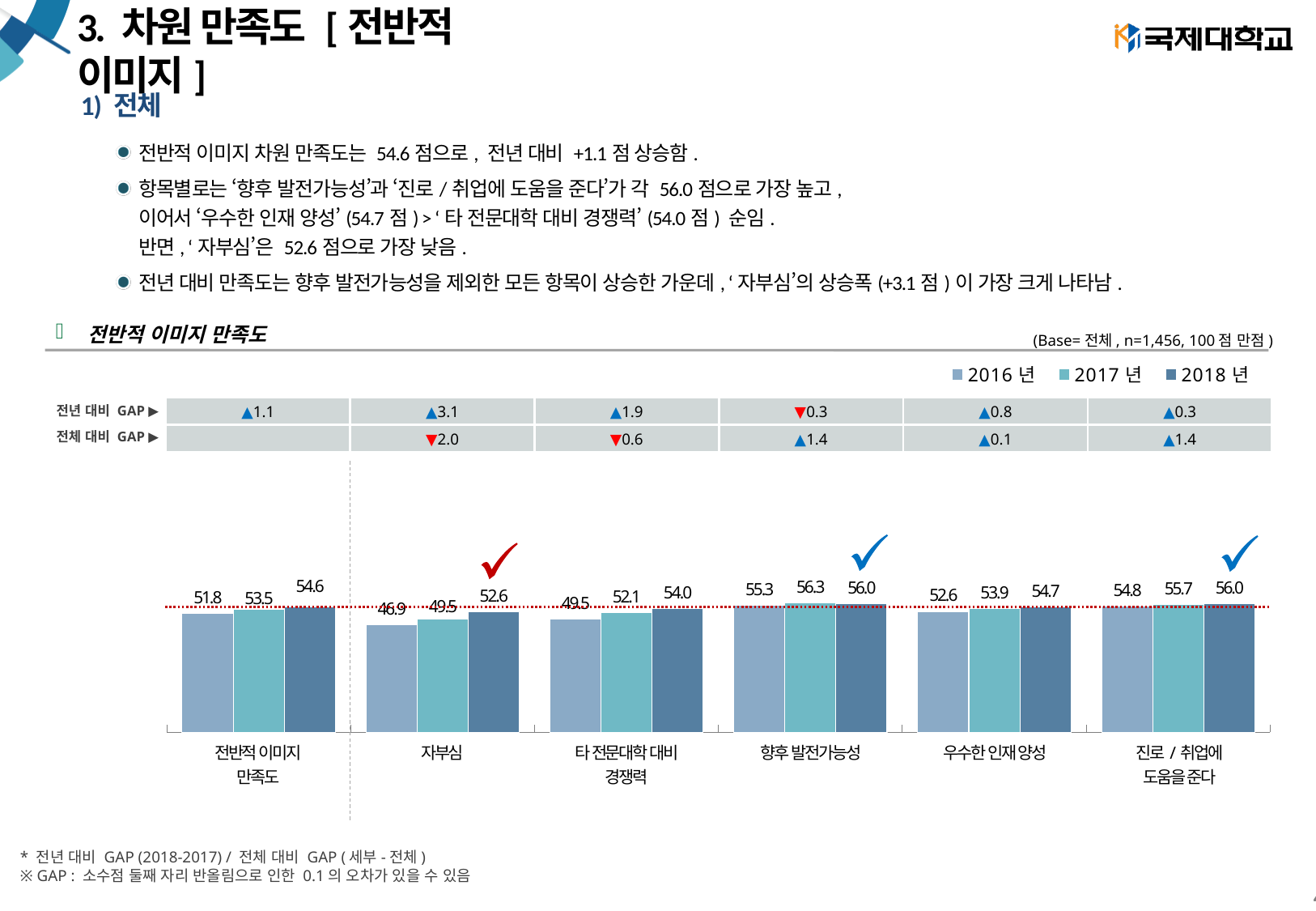
How many categories are shown on the x axis of the chart? 6 What type of chart is shown on the slide? bar chart How many series does the legend list? 3 What is the 2017년 value for 향후 발전가능성? 56.3 What is the 2016년 value for 자부심? 46.9 Which category has the highest 2016년 value? 향후 발전가능성 Which category has the lowest 2018년 value? 자부심 Do the values for 우수한 인재양성 rise or fall from 2016년 to 2018년? rise What is the 2018년 value for 전반적 이미지 만족도? 54.6 Which is larger for 타 전문대학 대비 경쟁력: the 2016년 value or the 2018년 value? 2018년 What is the difference between the 2018년 and 2017년 values for 자부심? 3.1 Which series is shown in the darkest blue colour in the legend? 2018년